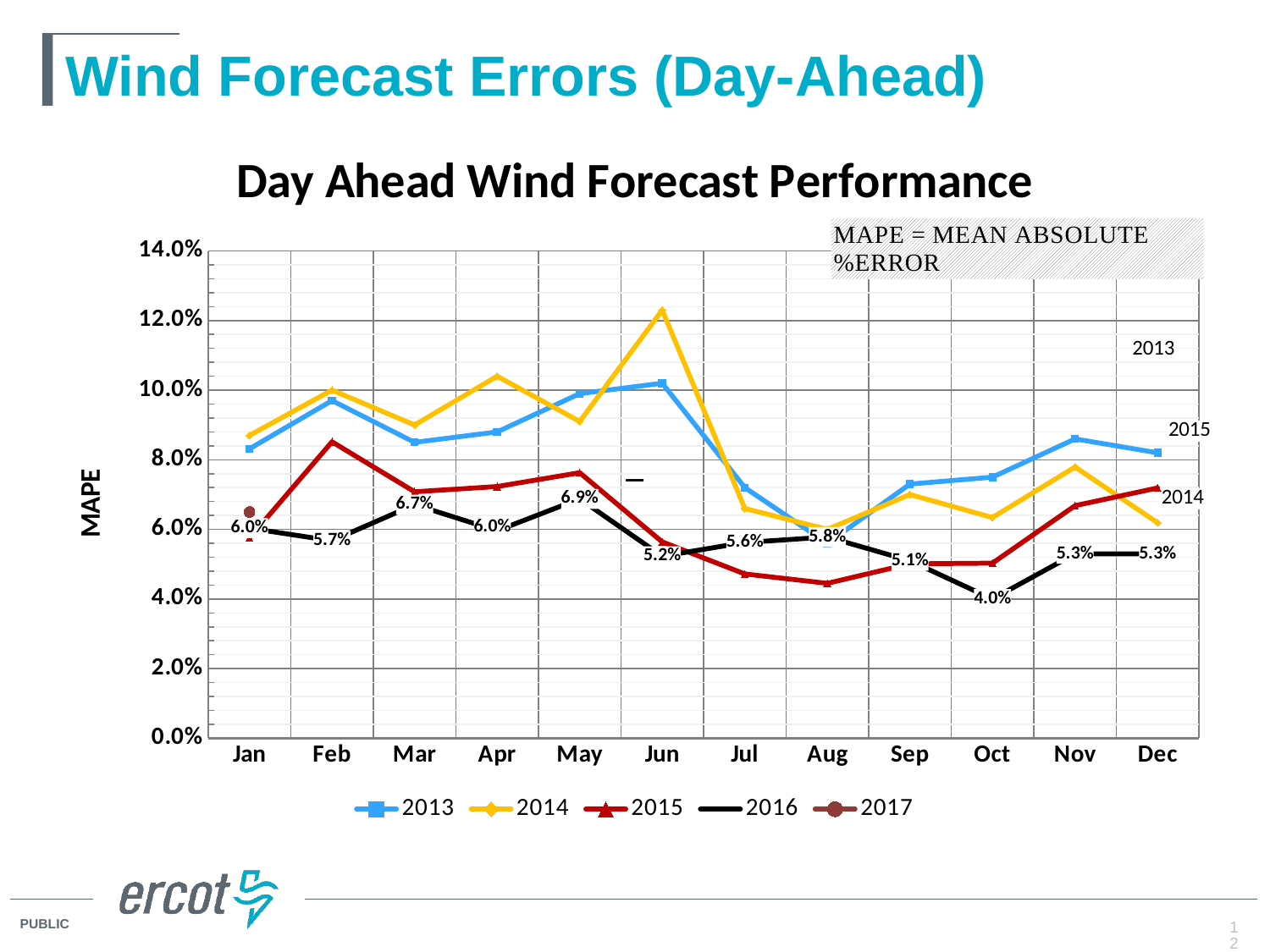
What is the difference between the 2016 values for Mar and Feb? 1.0% What is the 2016 MAPE value for Jun? 5.2% How many series does the legend list? 5 What is the title of the chart? Day Ahead Wind Forecast Performance In which month is the 2016 series lowest? Oct What is the 2016 MAPE value for May? 6.9% In which month is the 2016 series highest? May What is the 2016 MAPE value for Oct? 4.0% How many months are shown on the x axis? 12 What type of chart is shown on the slide? line chart Which is larger in Feb, the 2014 value or the 2015 value? 2014 Is the 2014 value for Jun greater or less than 12.0%? greater